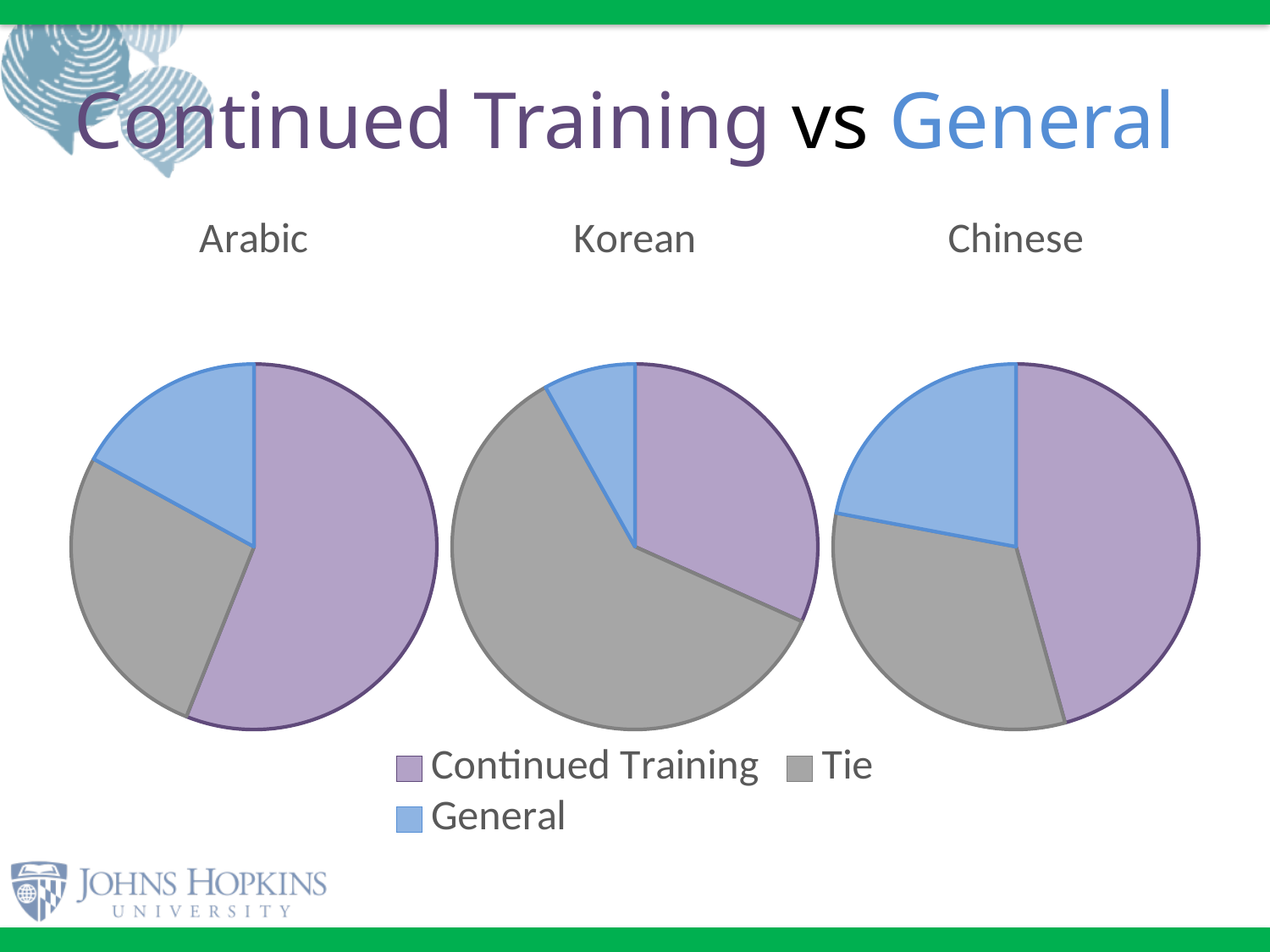
In the Arabic pie chart, which slice is larger: Tie or General? Tie In the Chinese pie chart, which category has the smallest slice? General In the Korean pie chart, which slice is larger: Continued Training or Tie? Tie How many categories does the legend list for the pie charts? 3 In the Chinese pie chart, which category has the largest slice? Continued Training Which colour represents the General category in the pie charts? Blue What kind of chart is used for the Arabic, Korean and Chinese results on this slide? Pie chart In the Korean pie chart, which category has the largest slice? Tie In the Arabic pie chart, which category has the smallest slice? General In the Arabic pie chart, which category has the largest slice? Continued Training How many pie charts are shown on the slide? 3 In the Korean pie chart, which category has the smallest slice? General